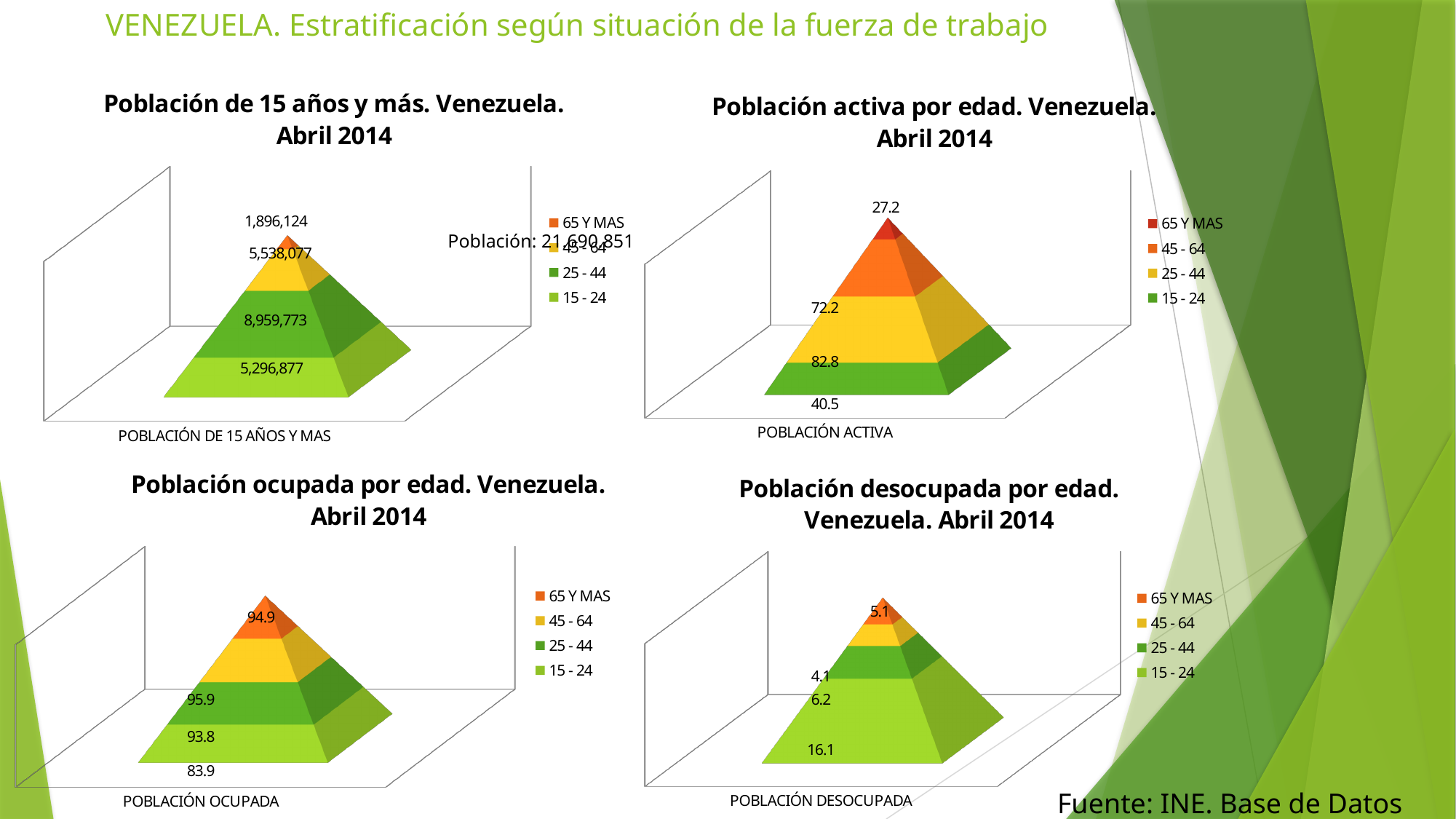
In the chart 'Población desocupada por edad. Venezuela. Abril 2014', what is the value for the 15 - 24 age group? 16.1 How many age groups does the legend list in the chart 'Población activa por edad. Venezuela. Abril 2014'? 4 In the chart 'Población de 15 años y más. Venezuela. Abril 2014', what is the value for the 65 Y MAS age group? 1,896,124 In the chart 'Población de 15 años y más. Venezuela. Abril 2014', what is the value for the 25 - 44 age group? 8,959,773 In the chart 'Población activa por edad. Venezuela. Abril 2014', which age group has the lowest value? 65 Y MAS In the chart 'Población de 15 años y más. Venezuela. Abril 2014', which age group has the largest value? 25 - 44 In the chart 'Población de 15 años y más. Venezuela. Abril 2014', what is the difference between the 45 - 64 value and the 15 - 24 value? 241,200 How many charts are shown on the slide? 4 In the chart 'Población de 15 años y más. Venezuela. Abril 2014', what is the total population shown for all age groups? 21,690,851 In the chart 'Población ocupada por edad. Venezuela. Abril 2014', what is the value for the 15 - 24 age group? 83.9 In the chart 'Población activa por edad. Venezuela. Abril 2014', what is the value for the 25 - 44 age group? 82.8 In the chart 'Población desocupada por edad. Venezuela. Abril 2014', which age group has the highest value? 15 - 24